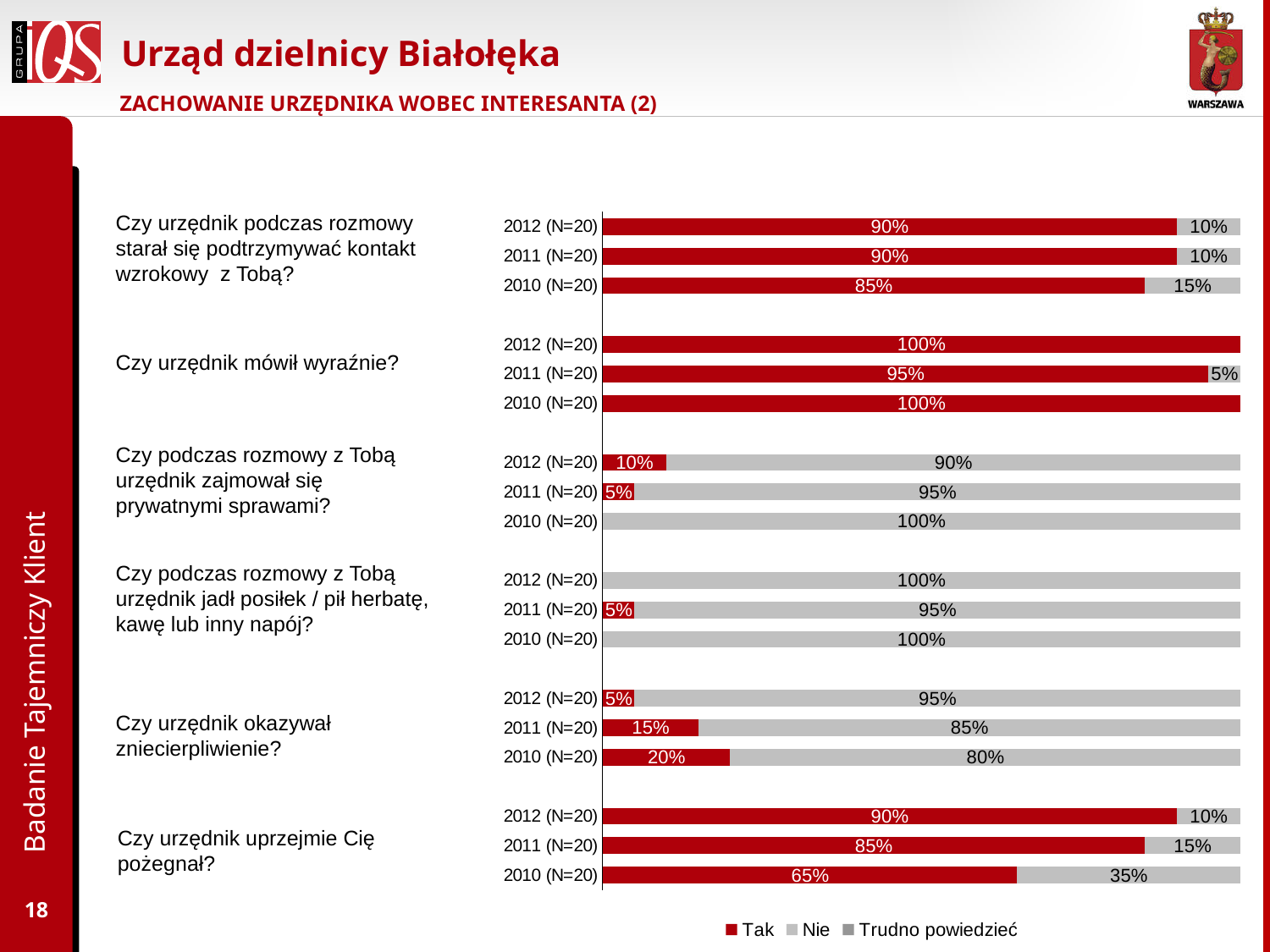
For "Czy urzędnik uprzejmie Cię pożegnał?", which year has the lowest "Tak" share? 2010 (N=20) For "Czy urzędnik okazywał zniecierpliwienie?", which year has the highest "Tak" share? 2010 (N=20) How many series does the legend list? 3 For "Czy urzędnik okazywał zniecierpliwienie?", is the "Tak" share larger in 2011 or in 2012? 2011 (N=20) What is the total of the 2011 bar for "Czy urzędnik mówił wyraźnie?" (95% Tak plus 5% Nie)? 100% What percentage answered "Tak" in 2012 for "Czy urzędnik podczas rozmowy starał się podtrzymywać kontakt wzrokowy z Tobą?"? 90% What percentage answered "Tak" in 2010 for "Czy urzędnik uprzejmie Cię pożegnał?"? 65% What percentage answered "Nie" in 2010 for "Czy urzędnik podczas rozmowy starał się podtrzymywać kontakt wzrokowy z Tobą?"? 15% For "Czy urzędnik uprzejmie Cię pożegnał?", does the "Tak" share rise or fall from 2010 to 2012? Rise What percentage answered "Tak" in 2011 for "Czy urzędnik mówił wyraźnie?"? 95% For "Czy urzędnik uprzejmie Cię pożegnał?", what is the difference between the "Tak" share in 2012 and in 2010? 25% What kind of chart is shown on the slide? Stacked bar chart